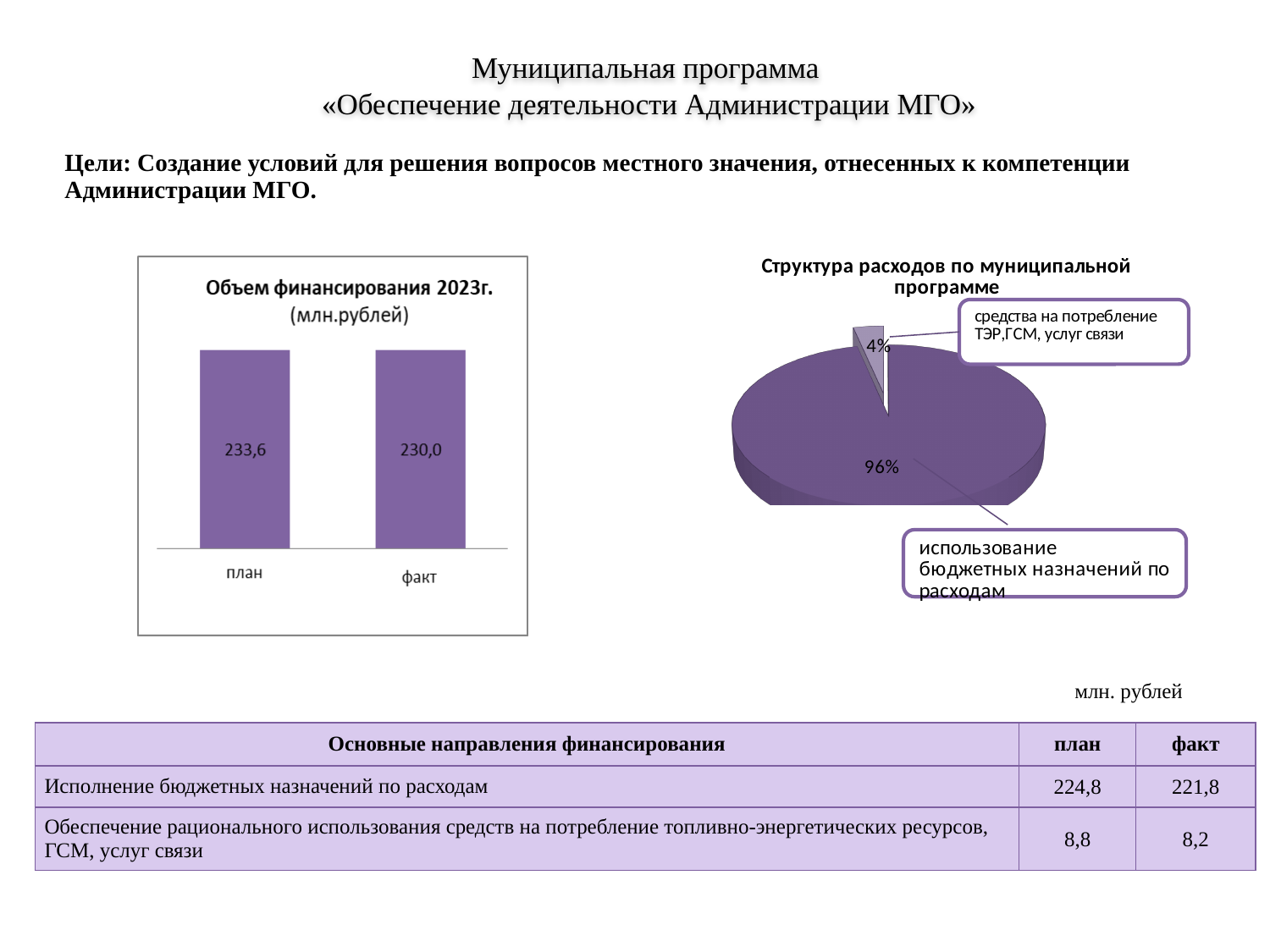
In the chart "Объем финансирования 2023г.", which category has the higher value? план What kind of chart is "Структура расходов по муниципальной программе"? pie chart What kind of chart is "Объем финансирования 2023г."? bar chart In the chart "Объем финансирования 2023г.", which category has the lower value? факт In the chart "Структура расходов по муниципальной программе", what share is labelled for использование бюджетных назначений по расходам? 96% In the chart "Структура расходов по муниципальной программе", how many slices does the pie have? 2 In the chart "Объем финансирования 2023г.", what is the value for план? 233,6 In the chart "Объем финансирования 2023г.", what unit is given in the title? млн.рублей In the chart "Объем финансирования 2023г.", what is the value for факт? 230,0 In the chart "Объем финансирования 2023г.", what is the difference between план and факт? 3,6 In the chart "Структура расходов по муниципальной программе", what share is labelled for средства на потребление ТЭР, ГСМ, услуг связи? 4% In the chart "Объем финансирования 2023г.", how many bars are shown? 2